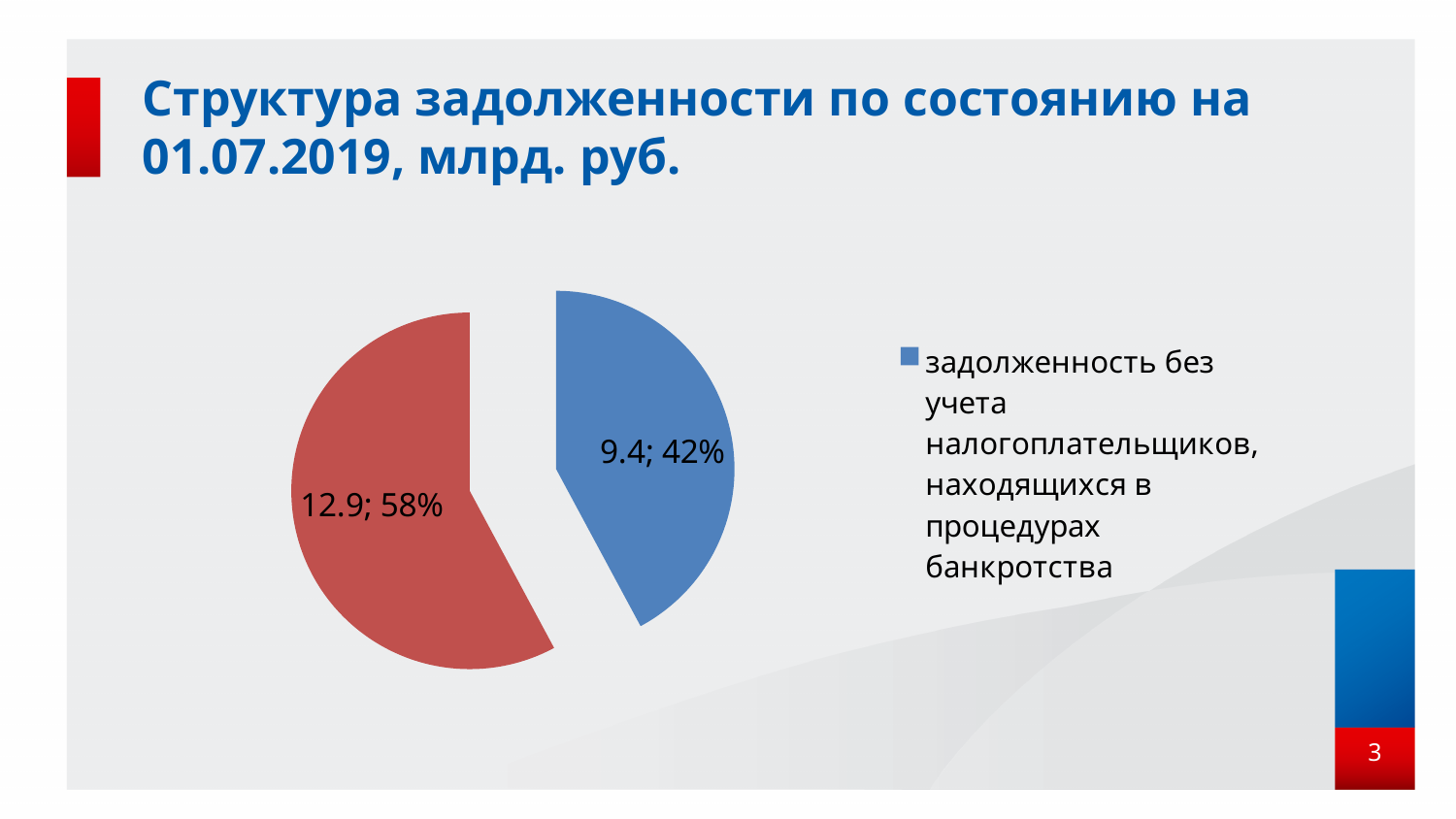
What share of the pie does the slice 'задолженность без учета налогоплательщиков, находящихся в процедурах банкротства' represent? 42% What value is printed on the red slice of the pie chart? 12.9 What kind of chart is shown on the slide? pie chart How many entries does the legend of the pie chart list? 1 What is the difference between the value of the red slice (12.9) and the blue slice (9.4)? 3.5 Which slice of the pie chart is the smallest? the blue slice, задолженность без учета налогоплательщиков, находящихся в процедурах банкротства (9.4; 42%) What percentage is printed on the red slice of the pie chart? 58% How many slices does the pie chart have? 2 What is the title of the chart on the slide? Структура задолженности по состоянию на 01.07.2019, млрд. руб. Which is larger: the red slice or the blue slice of the pie chart? the red slice What is the value shown for the slice labelled 'задолженность без учета налогоплательщиков, находящихся в процедурах банкротства'? 9.4 Which slice of the pie chart is the largest? the red slice (12.9; 58%)